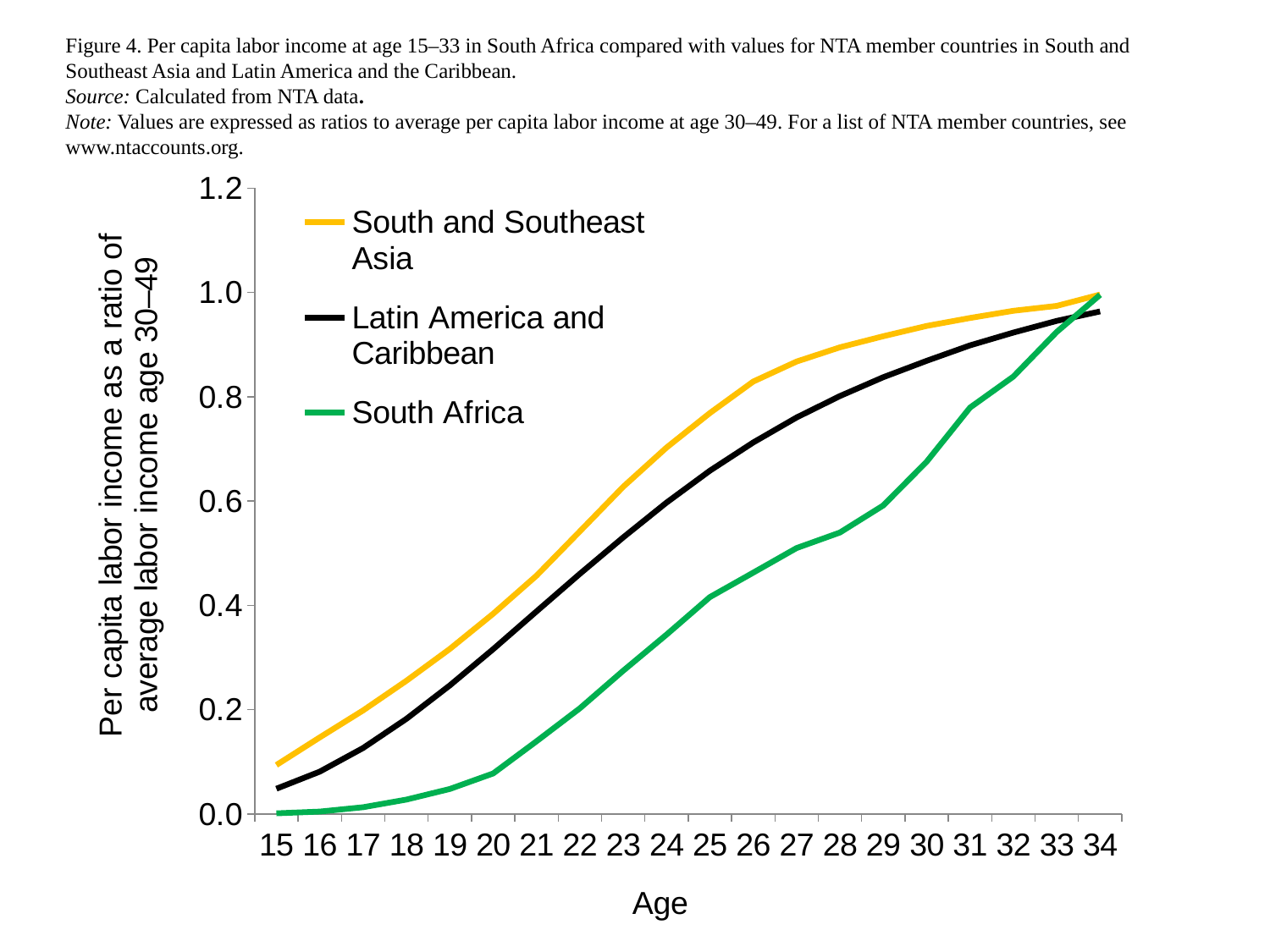
Is the value for South Africa at age 28 greater or less than 0.6? less Does the South Africa line rise or fall as age increases from 15 to 34? Rises What kind of chart is shown on the slide? Line chart Is the value for South Africa at age 20 greater or less than 0.2? less Is the value for Latin America and Caribbean at age 30 greater or less than 0.8? greater Which series has the lowest value at age 20? South Africa How many series does the legend list? 3 How many age points are shown along the x axis? 20 What colour is the line for Latin America and Caribbean? Black Which series has the highest value at age 25? South and Southeast Asia At age 25, which is larger: the value for South and Southeast Asia or the value for South Africa? South and Southeast Asia